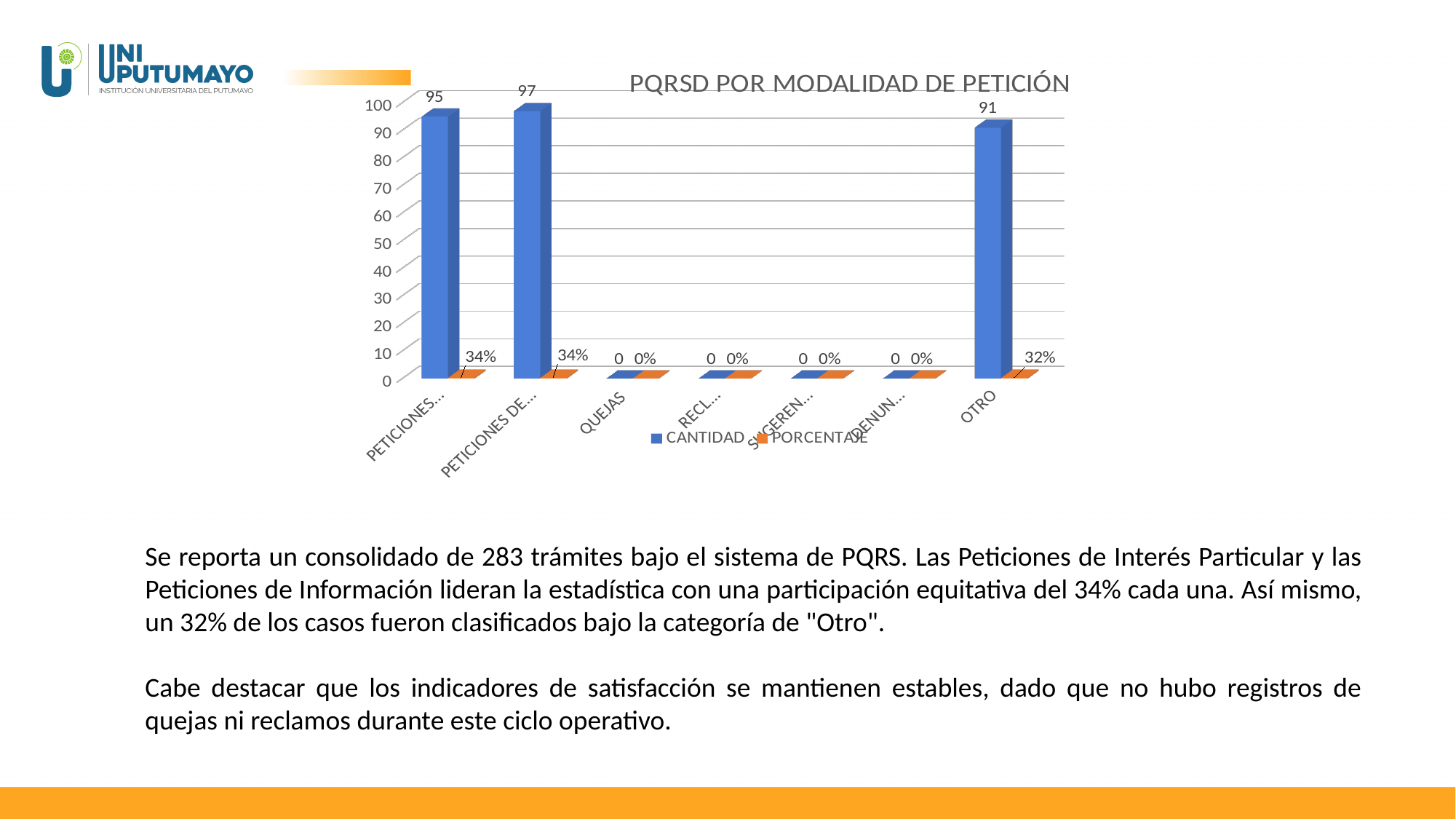
What is the difference between the CANTIDAD values for OTRO and QUEJAS? 91 How many categories are shown on the x axis of the chart? 7 What is the title of the chart? PQRSD POR MODALIDAD DE PETICIÓN What are the two series named in the legend? CANTIDAD and PORCENTAJE What is the CANTIDAD value for OTRO? 91 What is the PORCENTAJE value for OTRO? 32% How many series does the chart legend list? 2 What kind of chart is shown on the slide? bar chart What is the PORCENTAJE value for QUEJAS? 0% Is the CANTIDAD value for OTRO greater or less than 50? greater What is the CANTIDAD value for QUEJAS? 0 Which has a larger CANTIDAD value, OTRO or QUEJAS? OTRO